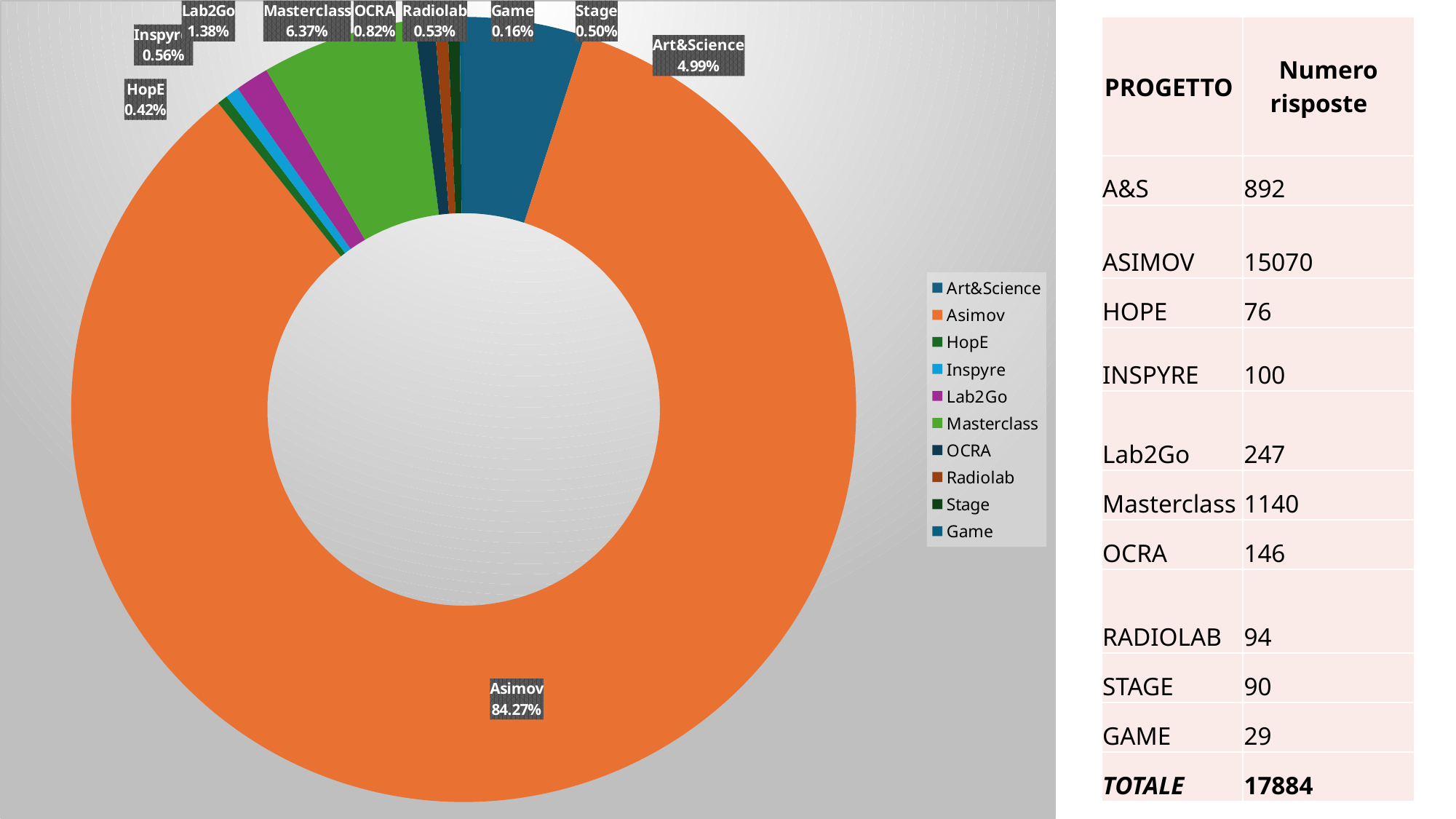
Which legend entry is listed last in the chart's legend? Game Which category has the largest share in the chart? Asimov How many categories does the legend of the chart list? 10 What percentage share does Game have in the chart? 0.16% What percentage share does Asimov have in the chart? 84.27% Which category has the smallest share in the chart? Game Which has a larger share, Masterclass or Art&Science? Masterclass What is the difference in percentage points between the Lab2Go share and the OCRA share? 0.56% What percentage share does Art&Science have in the chart? 4.99% What percentage share does Masterclass have in the chart? 6.37% What colour is the Asimov slice in the chart? Orange What kind of chart is shown on the slide? Doughnut (pie) chart